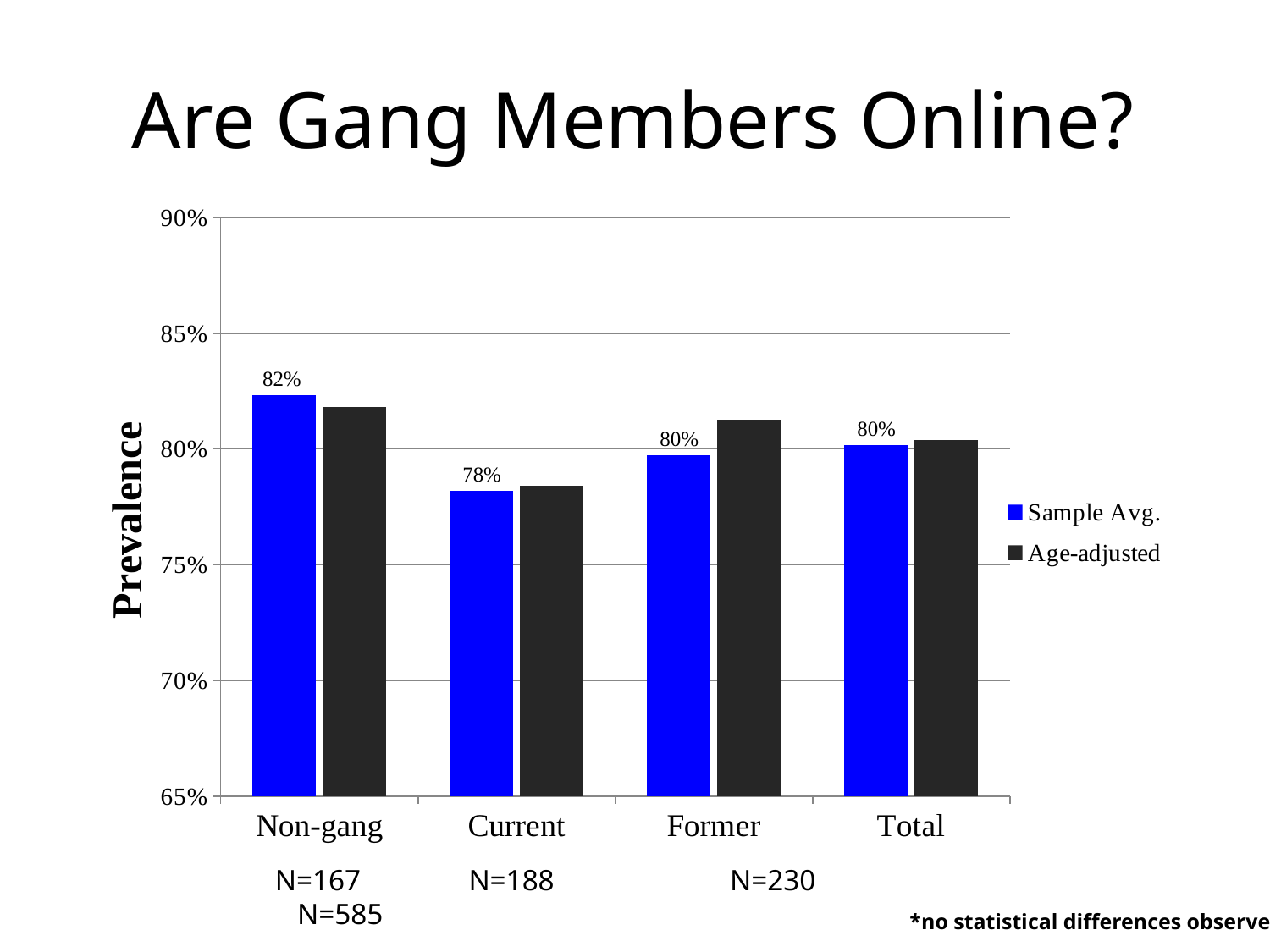
What is the Sample Avg. value for Former? 80% What kind of chart is shown on the slide? Bar chart What is the Sample Avg. value for Non-gang? 82% What is the Sample Avg. value for Current? 78% How many series does the legend list? 2 What is the difference between the Sample Avg. values for Non-gang and Current? 4 percentage points Is the Age-adjusted value for Current greater or less than 80%? less How many categories are shown on the x axis? 4 Which has a larger Sample Avg. value, Non-gang or Current? Non-gang Which category has the highest Sample Avg. value? Non-gang Which category has the lowest Sample Avg. value? Current Is the Age-adjusted value for Former greater or less than 80%? greater